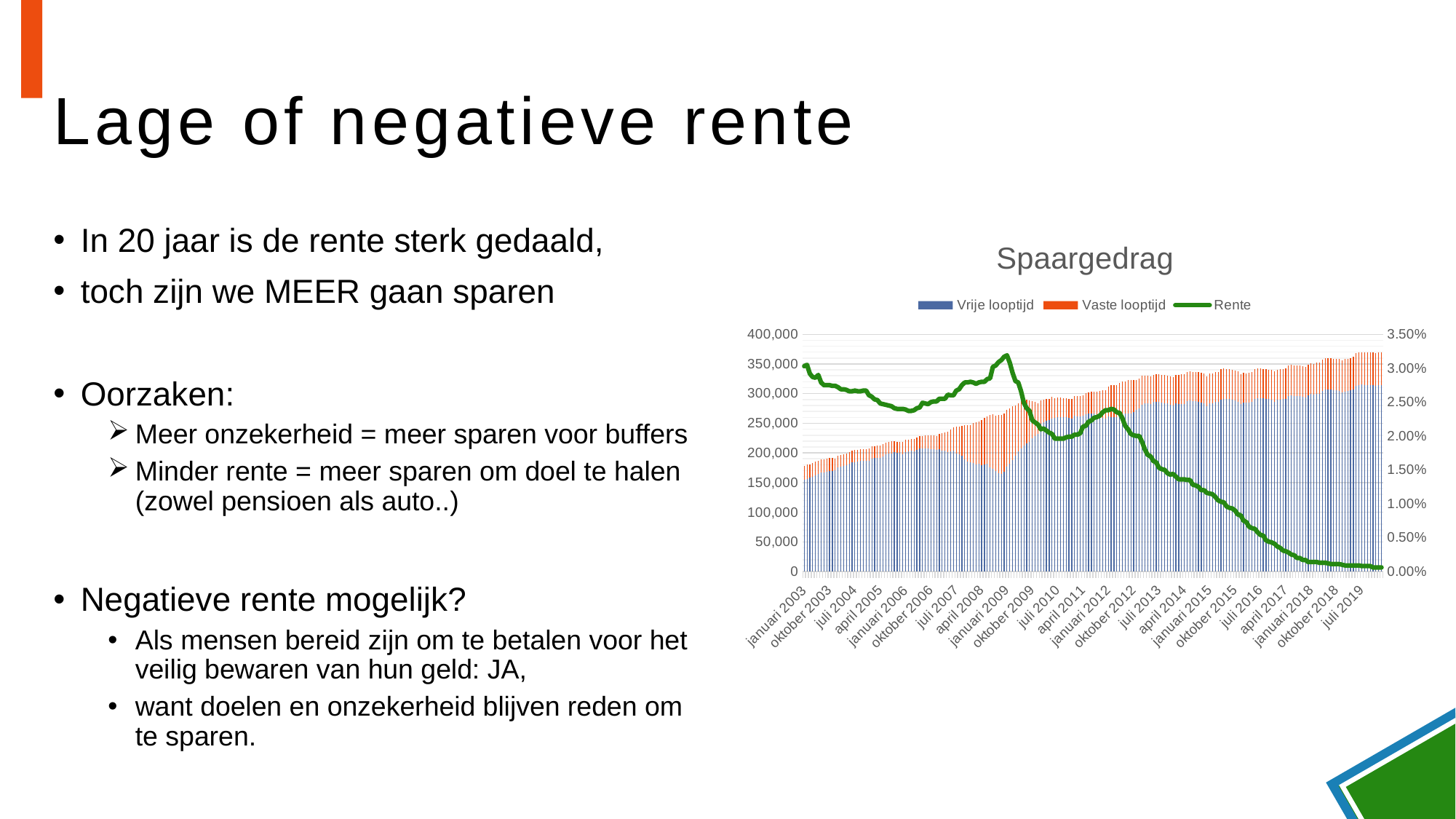
Is the total stacked bar for januari 2003 in the Spaargedrag chart greater or less than 200,000? less What kind of chart is the Spaargedrag chart? Combined stacked bar and line chart Which series in the Spaargedrag chart is drawn as a line rather than bars? Rente In the Spaargedrag chart, is the Rente value higher in januari 2003 or in juli 2019? januari 2003 Do the stacked bars (Vrije looptijd plus Vaste looptijd) in the Spaargedrag chart overall rise or fall from januari 2003 to juli 2019? rise Does the Rente line in the Spaargedrag chart overall rise or fall from januari 2003 to juli 2019? fall Is the Rente value for januari 2017 in the Spaargedrag chart greater or less than 0.50%? less What is the title of the chart on the slide? Spaargedrag Is the Rente value for juli 2019 in the Spaargedrag chart greater or less than 0.50%? less How many series does the legend of the Spaargedrag chart list? 3